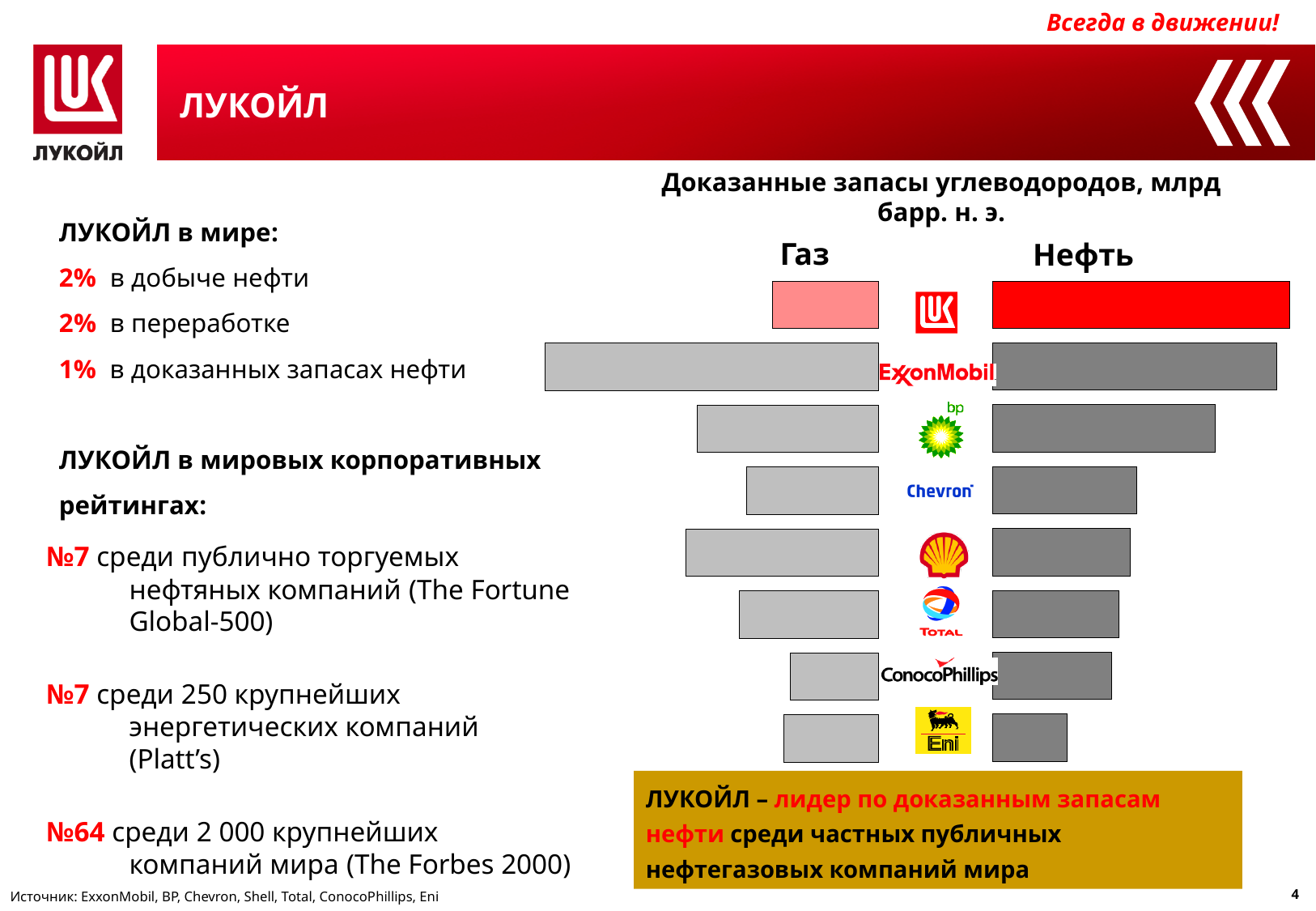
Which is larger for ExxonMobil: its gas (Газ) bar or BP's gas bar? ExxonMobil What kind of chart is shown on the slide? bar chart What are the two series shown in the chart? Газ and Нефть How many series does the chart show? 2 Which company has larger gas (Газ) reserves: Shell or Chevron? Shell Which company has the largest proven gas (Газ) reserves in the chart? ExxonMobil What is the title of the chart? Доказанные запасы углеводородов, млрд барр. н. э. Which company has larger oil (Нефть) reserves: BP or Chevron? BP How many companies are shown in the chart? 8 Which company has the smallest proven oil (Нефть) reserves in the chart? Eni Which company has the largest proven oil (Нефть) reserves in the chart? ЛУКОЙЛ